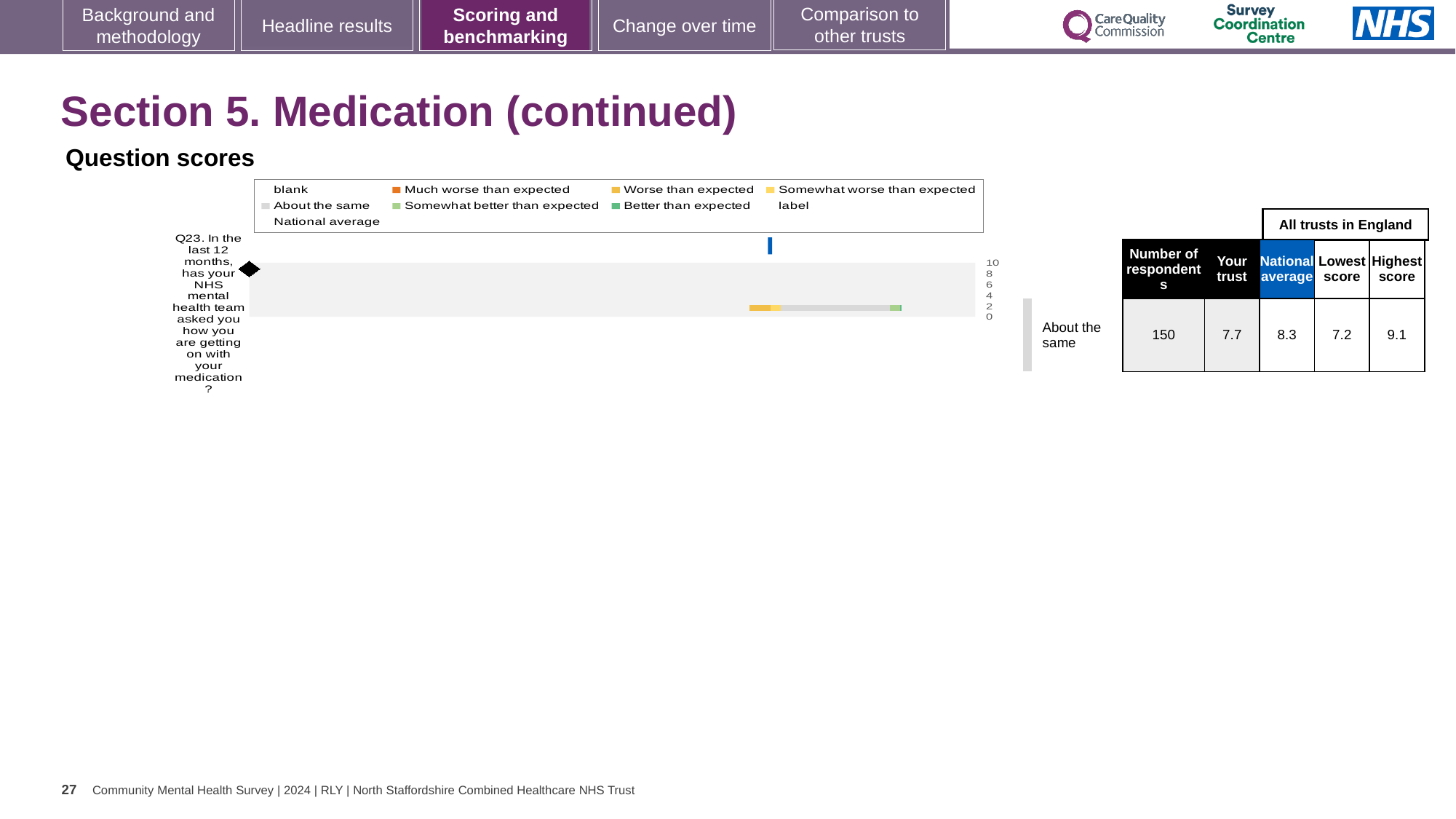
What kind of chart is shown under 'Question scores'? bar chart How many entries does the chart legend list? 9 What colour does the legend use for 'Much worse than expected'? orange In the table beside the chart, what is the highest score among all trusts in England for Q23? 9.1 How many questions (categories) are plotted in the chart? 1 What benchmark category is shown beside the chart for Q23? About the same In the table beside the chart, how many respondents answered Q23? 150 In the table beside the chart, what is the lowest score among all trusts in England for Q23? 7.2 Which question is plotted in the chart? Q23. In the last 12 months, has your NHS mental health team asked you how you are getting on with your medication? Which is larger for Q23, the 'Your trust' score or the national average? national average In the table beside the chart, what is the 'Your trust' score for Q23? 7.7 In the table beside the chart, what is the national average score for Q23? 8.3